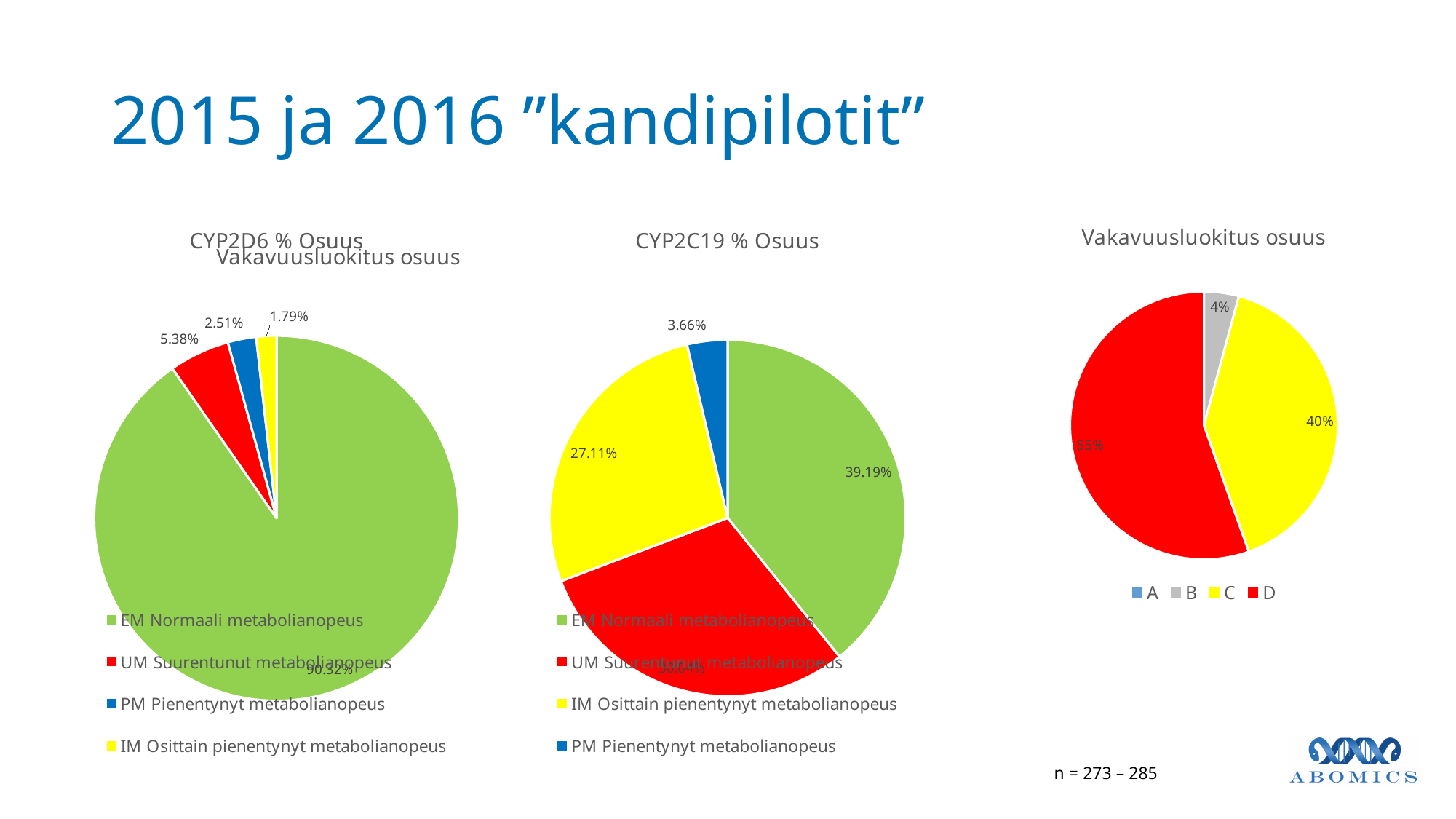
In the CYP2D6 % Osuus chart, what is the difference between the UM and PM percentages? 2.87% In the Vakavuusluokitus osuus chart, what is the difference between the percentages for D and C? 15% In the CYP2D6 % Osuus chart, what percentage is shown for IM Osittain pienentynyt metabolianopeus? 1.79% In the Vakavuusluokitus osuus chart, what percentage is shown for category D? 55% In the CYP2C19 % Osuus chart, which is larger, the EM slice or the IM slice? EM Normaali metabolianopeus In the CYP2C19 % Osuus chart, what percentage is shown for EM Normaali metabolianopeus? 39.19% In the CYP2D6 % Osuus chart, what percentage is shown for UM Suurentunut metabolianopeus? 5.38% In the CYP2C19 % Osuus chart, what percentage is shown for IM Osittain pienentynyt metabolianopeus? 27.11% In the CYP2D6 % Osuus chart, which category has the largest slice? EM Normaali metabolianopeus In the CYP2D6 % Osuus chart, what percentage is shown for PM Pienentynyt metabolianopeus? 2.51% In the CYP2C19 % Osuus chart, which category has the smallest slice? PM Pienentynyt metabolianopeus How many entries does the legend of the Vakavuusluokitus osuus chart list? 4